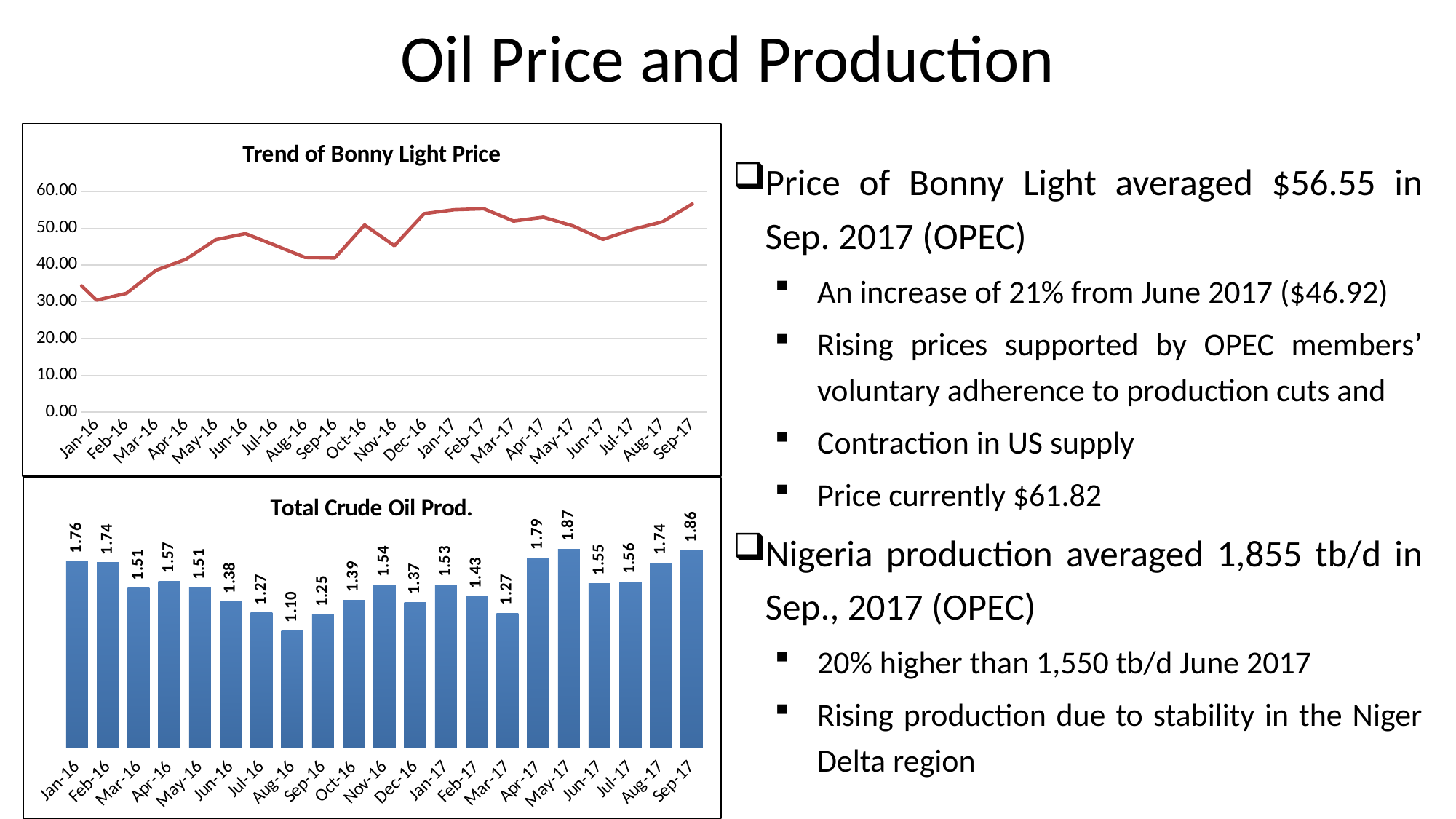
In the Trend of Bonny Light Price chart, is the value for Sep-17 greater or less than 50.00? greater In the Total Crude Oil Prod. chart, what is the difference between the values for Sep-17 and Jun-17? 0.31 What kind of chart is the Total Crude Oil Prod. chart? bar chart How many months are plotted in the Total Crude Oil Prod. chart? 21 In the Total Crude Oil Prod. chart, which month has the lowest value? Aug-16 In the Total Crude Oil Prod. chart, which month has the highest value? May-17 In the Total Crude Oil Prod. chart, which is larger, the value for Jan-16 or the value for Apr-17? Apr-17 In the Total Crude Oil Prod. chart, what is the value for Sep-17? 1.86 What kind of chart is the Trend of Bonny Light Price chart? line chart In the Total Crude Oil Prod. chart, what is the value for May-17? 1.87 In the Trend of Bonny Light Price chart, is the value for Jan-16 greater or less than 40.00? less In the Total Crude Oil Prod. chart, what is the value for Aug-16? 1.10